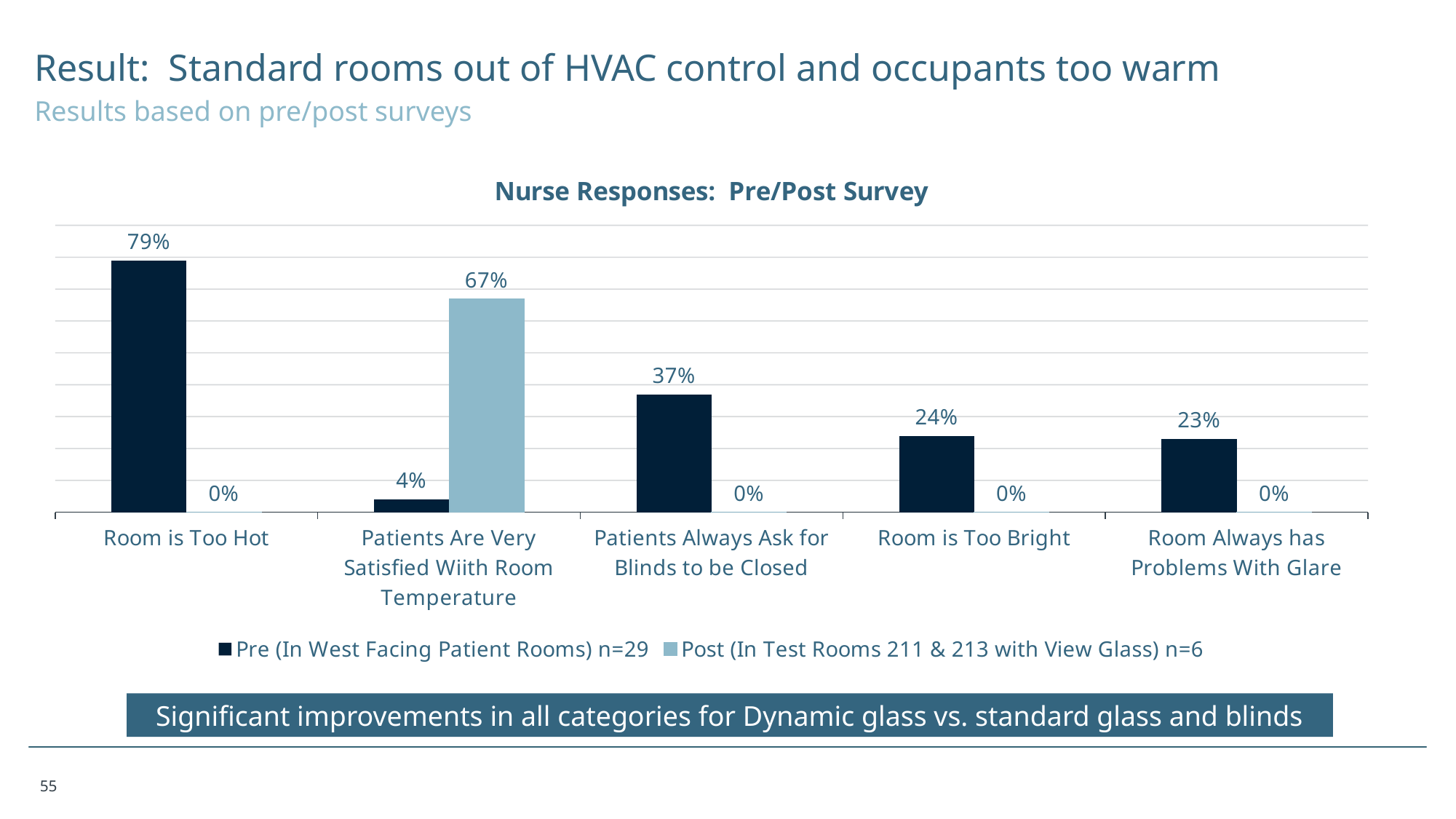
Which category has the lowest Pre value? Patients Are Very Satisfied Wiith Room Temperature What kind of chart is shown on the slide? Bar chart How many categories are shown on the x axis? 5 What is the Post value for "Patients Are Very Satisfied Wiith Room Temperature"? 67% How many series does the legend list? 2 What is the Post value for "Room is Too Bright"? 0% What is the title of the chart? Nurse Responses: Pre/Post Survey What is the Pre value for "Room is Too Hot"? 79% Which is larger: the Pre value for "Room is Too Bright" or the Pre value for "Room Always has Problems With Glare"? Room is Too Bright What is the Pre value for "Patients Always Ask for Blinds to be Closed"? 37% What is the difference between the Pre and Post values for "Patients Are Very Satisfied Wiith Room Temperature"? 63% Which category has the highest Pre value? Room is Too Hot